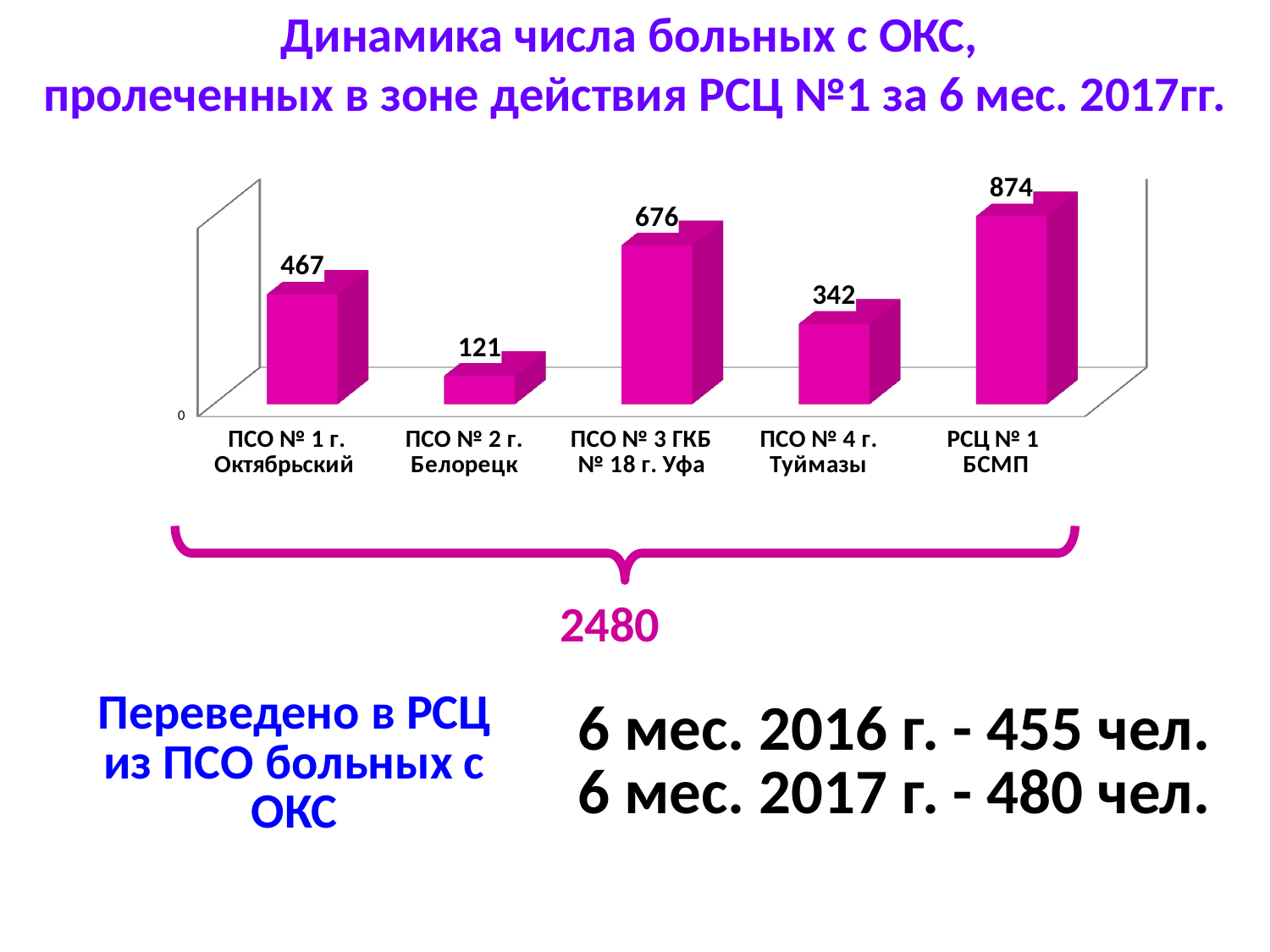
What kind of chart is shown on the slide? bar chart What is the value for ПСО № 4 г. Туймазы? 342 What total is shown under the bracket beneath the chart? 2480 Which is larger, the value for ПСО № 1 г. Октябрьский or ПСО № 4 г. Туймазы? ПСО № 1 г. Октябрьский What is the value for ПСО № 1 г. Октябрьский? 467 What is the value for ПСО № 2 г. Белорецк? 121 What is the value for ПСО № 3 ГКБ № 18 г. Уфа? 676 What is the difference between the values for РСЦ № 1 БСМП and ПСО № 3 ГКБ № 18 г. Уфа? 198 What is the value for РСЦ № 1 БСМП? 874 Which category has the highest value? РСЦ № 1 БСМП Which category has the lowest value? ПСО № 2 г. Белорецк How many categories are shown in the chart? 5